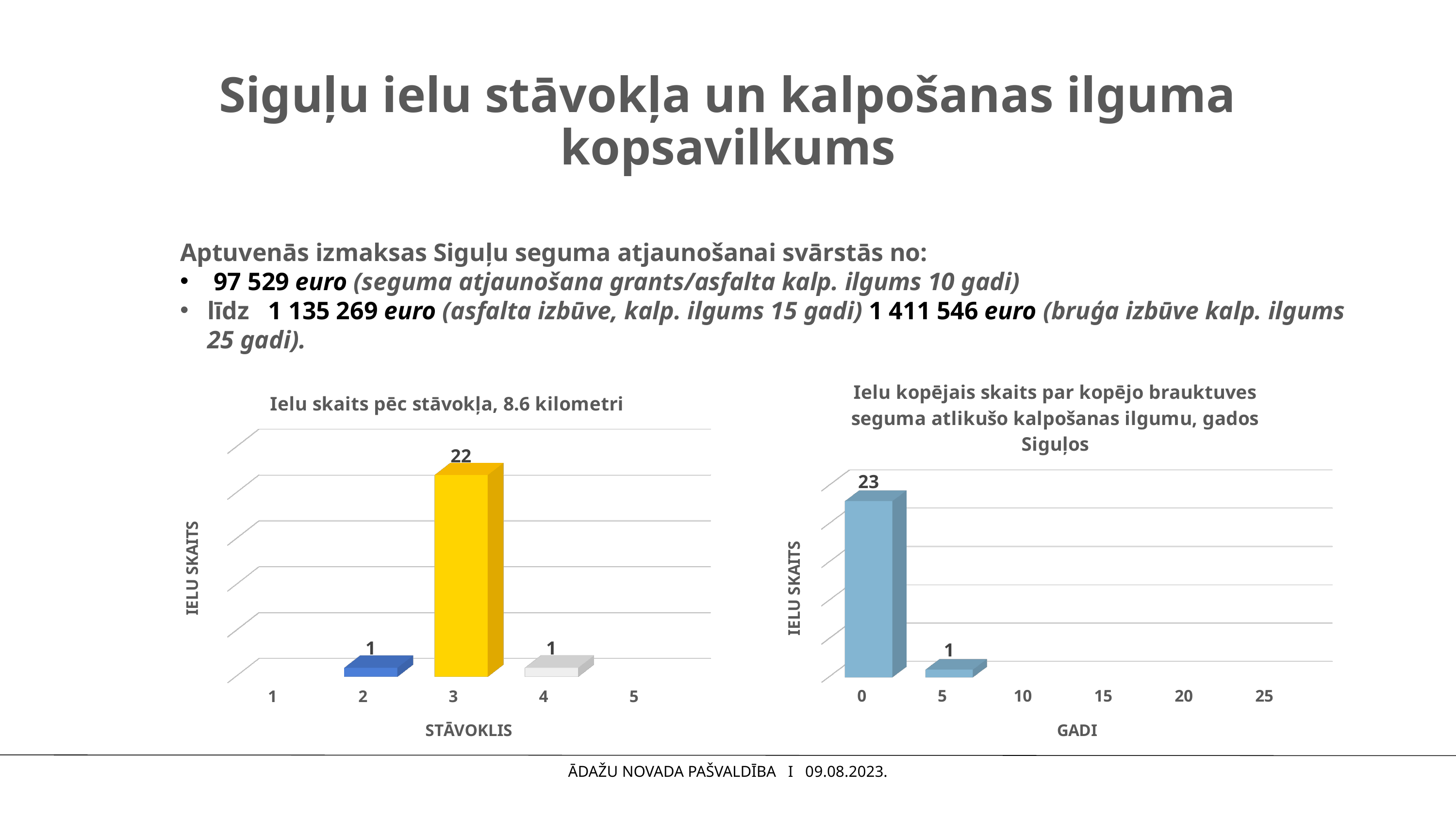
In the right chart 'Ielu kopējais skaits par kopējo brauktuves seguma atlikušo kalpošanas ilgumu', what is the difference between the values for 0 years and 5 years? 22 What is the x-axis title of the right chart 'Ielu kopējais skaits par kopējo brauktuves seguma atlikušo kalpošanas ilgumu'? GADI In the left chart 'Ielu skaits pēc stāvokļa, 8.6 kilometri', what is the difference between the values for condition 3 and condition 4? 21 In the right chart 'Ielu kopējais skaits par kopējo brauktuves seguma atlikušo kalpošanas ilgumu', what is the value for 0 years (gadi)? 23 In the left chart 'Ielu skaits pēc stāvokļa, 8.6 kilometri', what is the value for condition 2? 1 In the right chart 'Ielu kopējais skaits par kopējo brauktuves seguma atlikušo kalpošanas ilgumu', what is the value for 5 years? 1 In the right chart 'Ielu kopējais skaits par kopējo brauktuves seguma atlikušo kalpošanas ilgumu', which is larger: the value for 0 years or for 5 years? 0 years What type of chart is the left chart 'Ielu skaits pēc stāvokļa, 8.6 kilometri'? bar chart In the left chart 'Ielu skaits pēc stāvokļa, 8.6 kilometri', how many category labels are shown on the x axis? 5 In the left chart 'Ielu skaits pēc stāvokļa, 8.6 kilometri', what is the value for condition (stāvoklis) 3? 22 In the right chart 'Ielu kopējais skaits par kopējo brauktuves seguma atlikušo kalpošanas ilgumu', how many category labels are shown on the x axis? 6 In the left chart 'Ielu skaits pēc stāvokļa, 8.6 kilometri', which condition category has the highest number of streets? 3